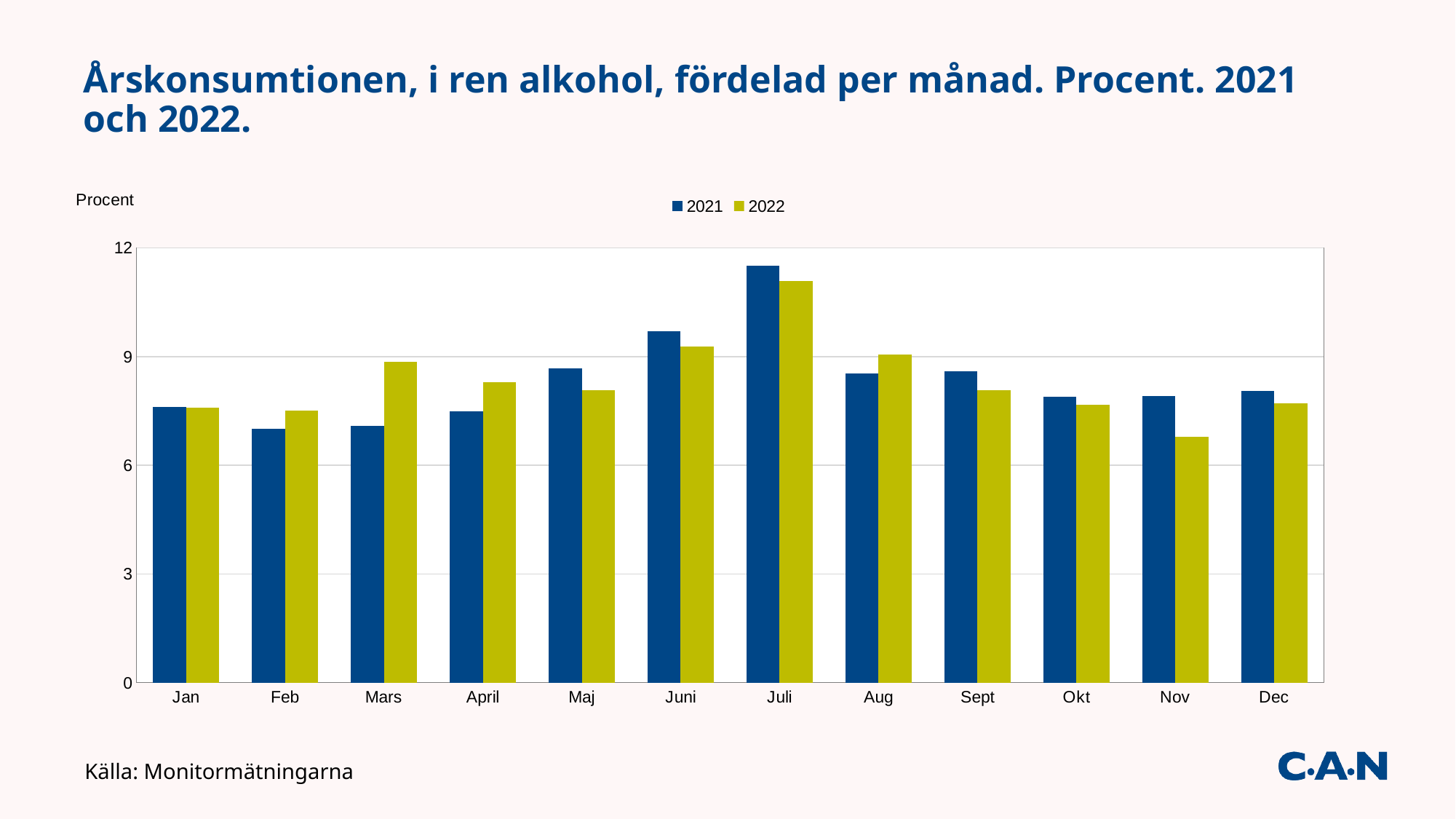
Is the value for Nov in 2022 greater or less than 9? less What kind of chart is shown on the slide? Bar chart How many months are shown on the x axis? 12 Which month has the highest value for 2022? Juli What label is shown on the y axis? Procent Is the value for Feb in 2021 greater or less than 6? greater For Nov, which year has the larger value, 2021 or 2022? 2021 How many series does the legend list? 2 Is the value for Juli in 2021 greater or less than 9? greater Which month has the lowest value for 2022? Nov Which month has the highest value for 2021? Juli For Mars, which year has the larger value, 2021 or 2022? 2022